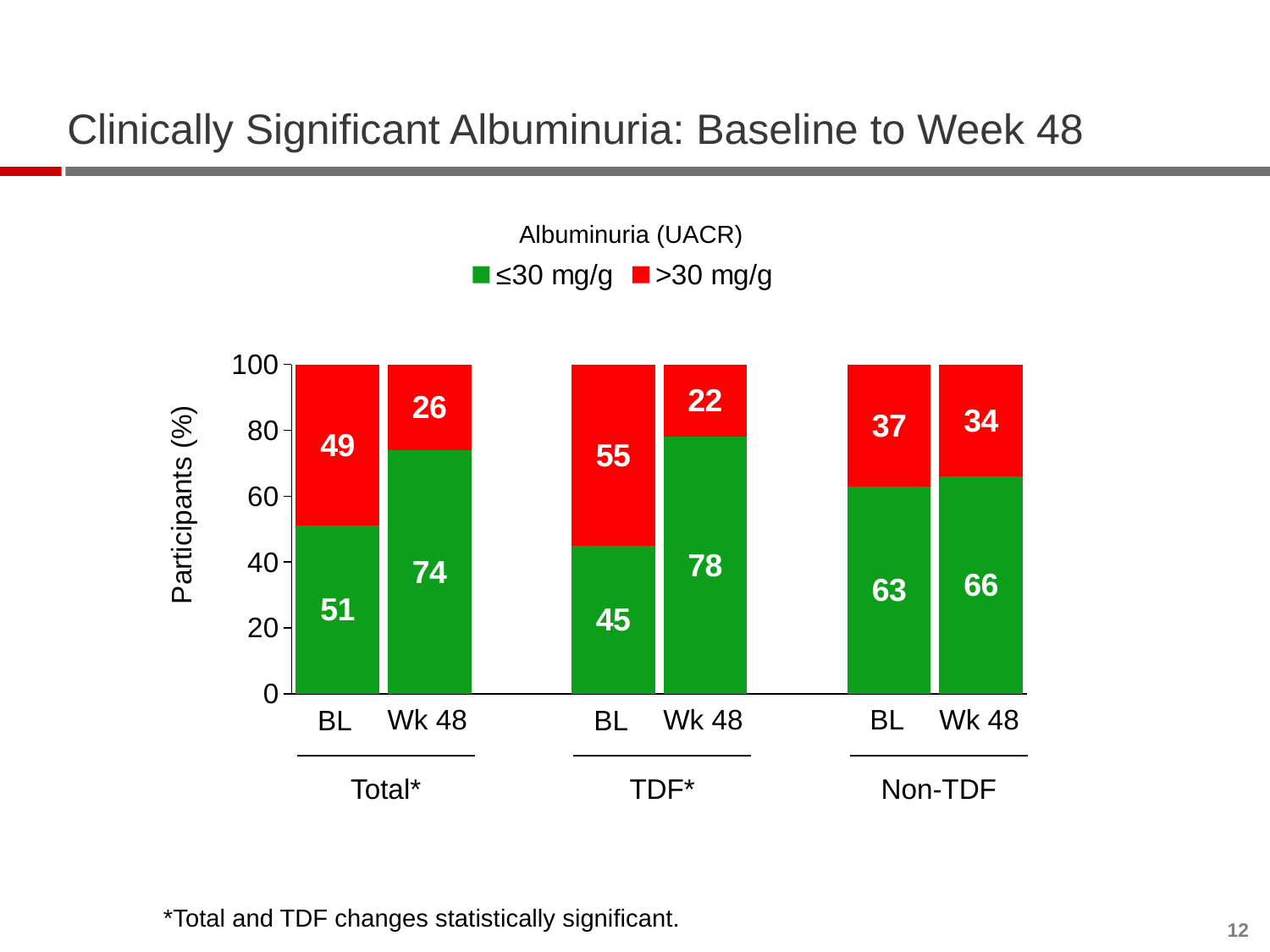
Which bar has the highest percentage of participants with albuminuria ≤30 mg/g? TDF Wk 48 What is the total of the stacked bar for Non-TDF at BL? 100 What percentage of participants in the TDF group had albuminuria >30 mg/g at Wk 48? 22 Which colour represents albuminuria >30 mg/g in the chart? Red Which is larger: the >30 mg/g share at BL in the Total group or in the Non-TDF group? Total How many stacked bars are shown in the chart? 6 By how many percentage points did the ≤30 mg/g share in the TDF group change from BL to Wk 48? 33 What kind of chart is shown on the slide? Stacked bar chart What percentage of participants in the Non-TDF group had albuminuria ≤30 mg/g at Wk 48? 66 Which bar has the lowest percentage of participants with albuminuria ≤30 mg/g? TDF BL How many series does the legend list? 2 What percentage of participants in the Total group had albuminuria ≤30 mg/g at baseline (BL)? 51